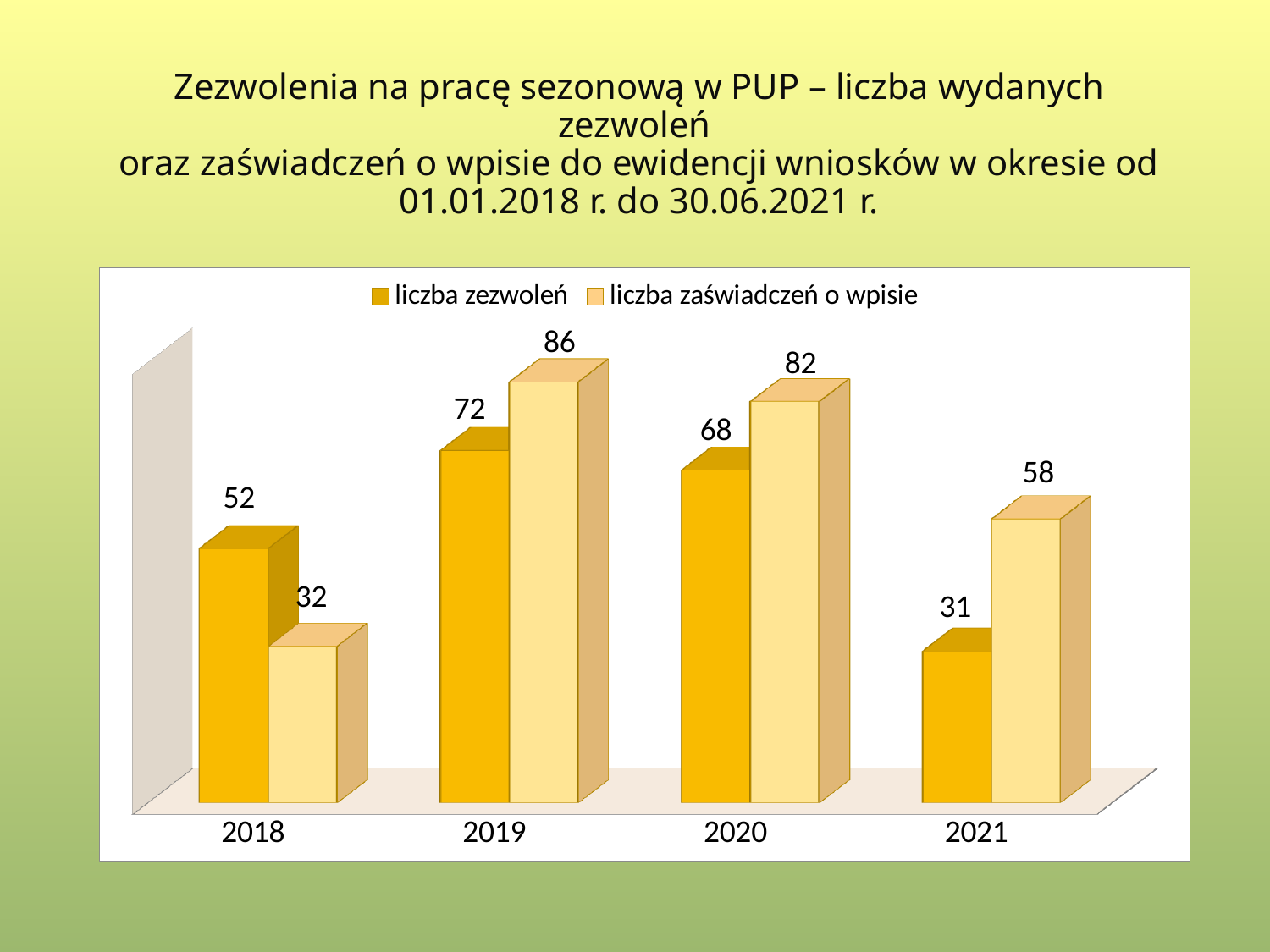
Which is larger in 2018: 'liczba zezwoleń' or 'liczba zaświadczeń o wpisie'? liczba zezwoleń What is the value of 'liczba zezwoleń' for 2019? 72 Does 'liczba zezwoleń' rise or fall from 2019 to 2021? fall How many series does the legend list? 2 How many years are shown on the x axis? 4 What is the difference between 'liczba zezwoleń' in 2019 and in 2021? 41 Which year has the highest value for 'liczba zezwoleń'? 2019 Which year has the lowest value for 'liczba zaświadczeń o wpisie'? 2018 What kind of chart is shown on the slide? bar chart What is the difference between 'liczba zaświadczeń o wpisie' and 'liczba zezwoleń' in 2020? 14 What is the value of 'liczba zaświadczeń o wpisie' for 2018? 32 What is the value of 'liczba zaświadczeń o wpisie' for 2021? 58